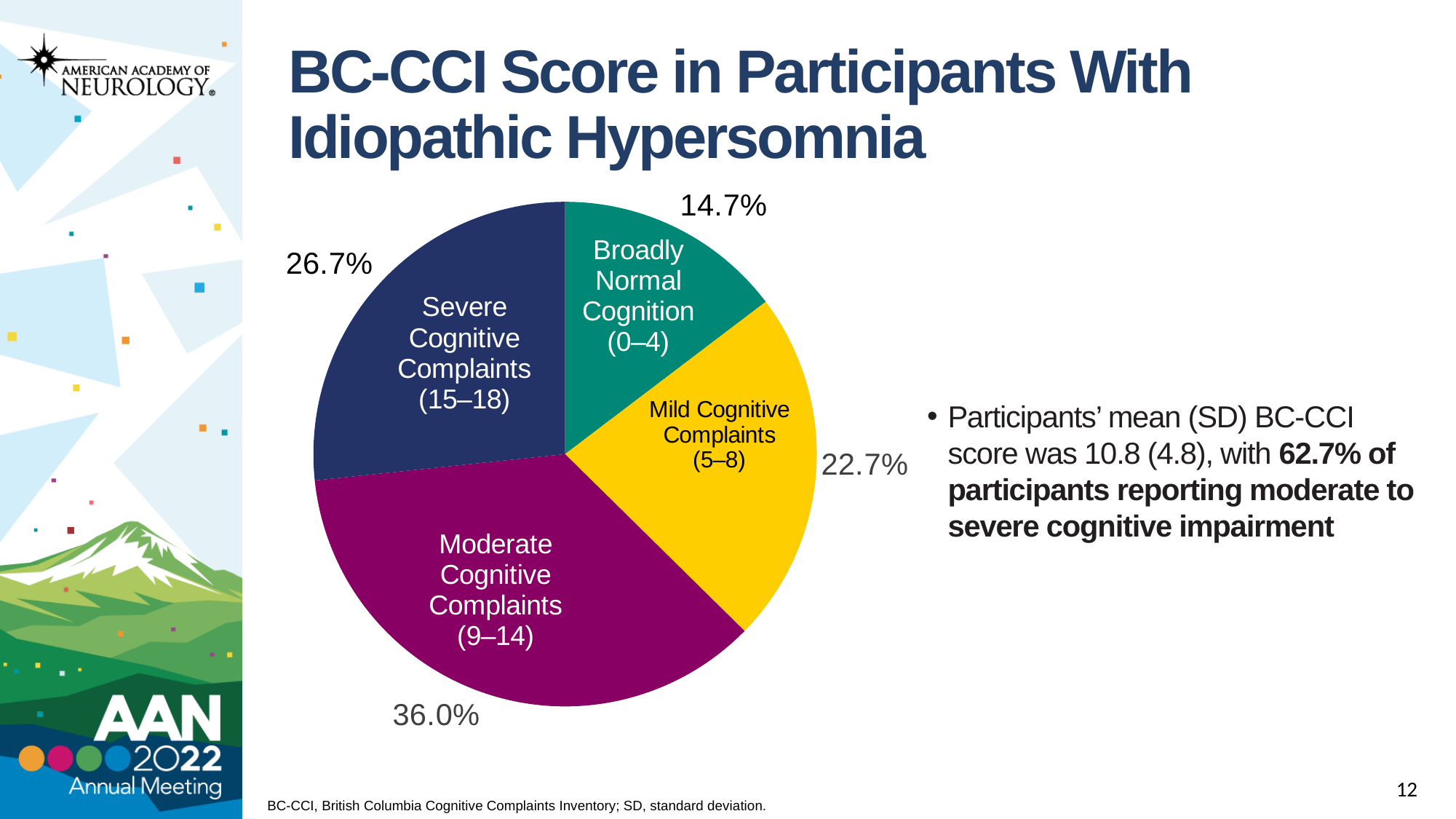
What is the combined share of Moderate and Severe Cognitive Complaints? 62.7% Which is larger: the share for Mild Cognitive Complaints or the share for Severe Cognitive Complaints? Severe Cognitive Complaints What kind of chart is shown on the slide? Pie chart What is the difference in percentage points between Moderate Cognitive Complaints and Severe Cognitive Complaints? 9.3 What colour is the slice for Mild Cognitive Complaints (5–8)? Yellow How many categories are shown in the pie chart? 4 Which category has the smallest share of the pie? Broadly Normal Cognition (0–4) What percentage of participants had Mild Cognitive Complaints (5–8)? 22.7% Which category has the largest share of the pie? Moderate Cognitive Complaints (9–14) What percentage of participants had Broadly Normal Cognition (0–4)? 14.7% What percentage of participants had Moderate Cognitive Complaints (9–14)? 36.0% What percentage of participants had Severe Cognitive Complaints (15–18)? 26.7%